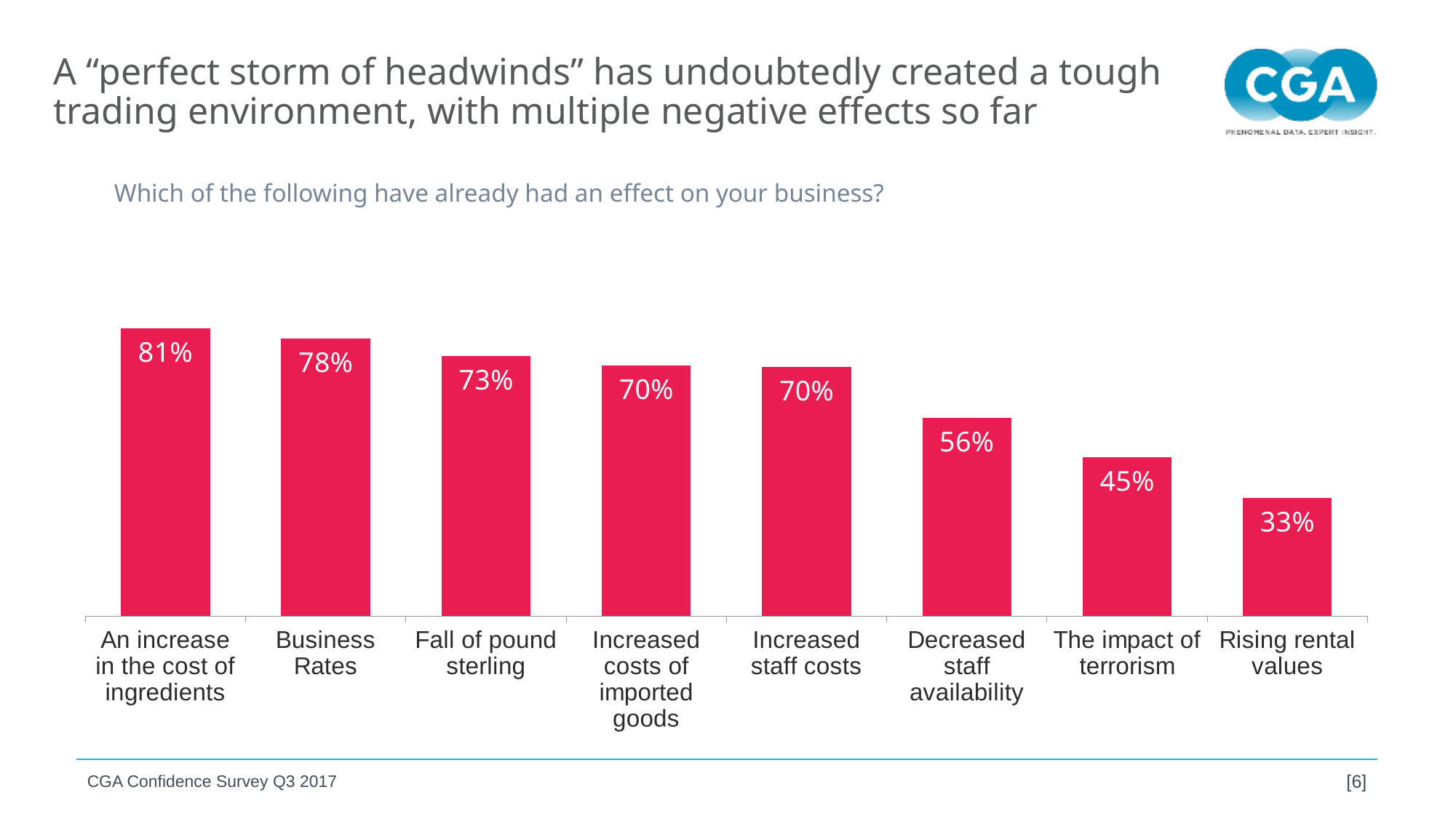
What is the difference between the values for Business Rates and Decreased staff availability? 22% Do the values rise or fall moving from left to right across the chart? Fall Which category has the highest value? An increase in the cost of ingredients What is the difference between the values for Fall of pound sterling and Rising rental values? 40% What is the value shown for The impact of terrorism? 45% What is the value shown for Decreased staff availability? 56% Which is larger, the value for Increased staff costs or the value for The impact of terrorism? Increased staff costs What is the value shown for Business Rates? 78% What kind of chart is shown on the slide? Bar chart How many categories are shown in the chart? 8 What percentage of respondents said an increase in the cost of ingredients has already had an effect on their business? 81% Which category has the lowest value? Rising rental values